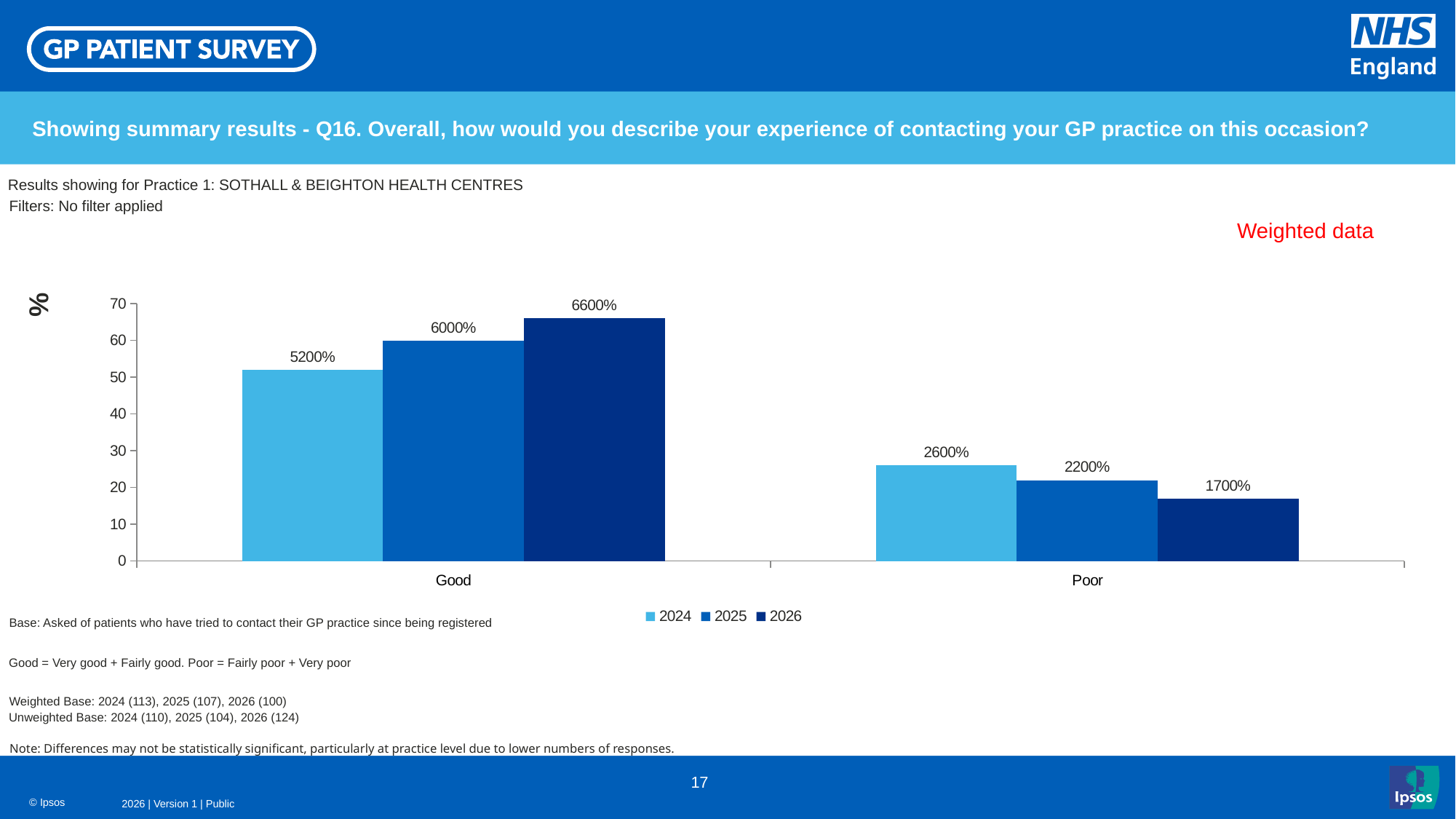
How many series does the legend list? 3 What kind of chart is shown on the slide? Bar chart What is the data label for 2026 in the Poor category? 1700% Do the Poor bars rise or fall from 2024 to 2026? Fall Which year has the highest bar in the Good category? 2026 What is the data label for 2025 in the Good category? 6000% How many categories are shown on the x axis? 2 Is the 2026 bar in the Good category greater or less than 60 on the axis? greater Which is larger in the Poor category, the 2024 bar or the 2025 bar? 2024 What is the data label for 2024 in the Good category? 5200% Is the 2026 bar in the Poor category greater or less than 20 on the axis? less Which year has the lowest bar in the Poor category? 2026